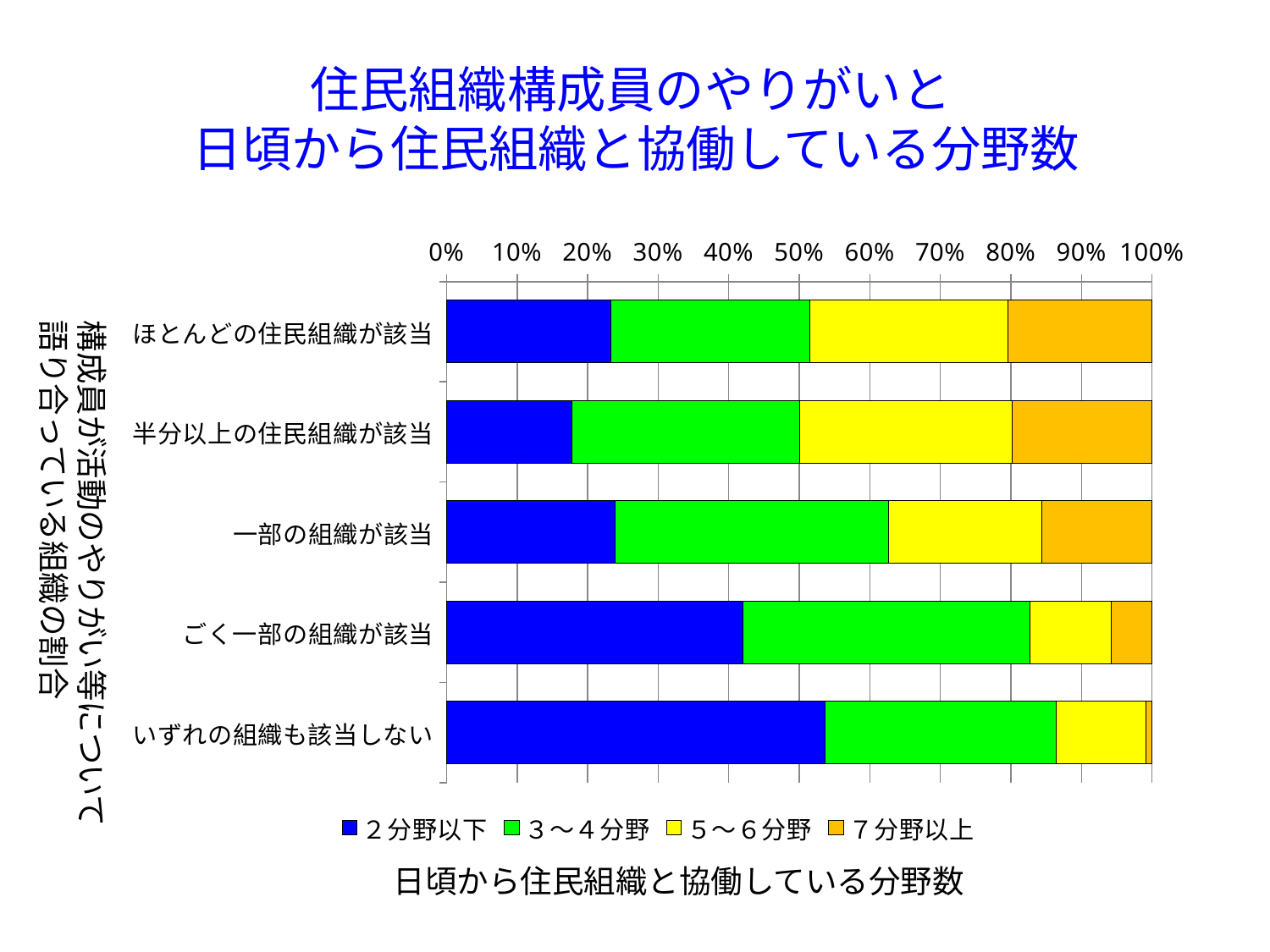
How many categories (rows) are plotted on the chart? 5 Which category has the largest share for 2分野以下? いずれの組織も該当しない Which is larger: the 2分野以下 share for ごく一部の組織が該当 or for ほとんどの住民組織が該当? ごく一部の組織が該当 Is the 2分野以下 share for 半分以上の住民組織が該当 greater or less than 20%? less Is the 2分野以下 share for いずれの組織も該当しない greater or less than 50%? greater How many series does the legend list? 4 What is the title of the horizontal axis below the legend? 日頃から住民組織と協働している分野数 What kind of chart is shown on the slide? Stacked bar chart Which category has the smallest share for 2分野以下? 半分以上の住民組織が該当 Is the 7分野以上 share for ごく一部の組織が該当 greater or less than 10%? less Which legend entry is shown in green? 3～4分野 Which category has the smallest share for 7分野以上? いずれの組織も該当しない